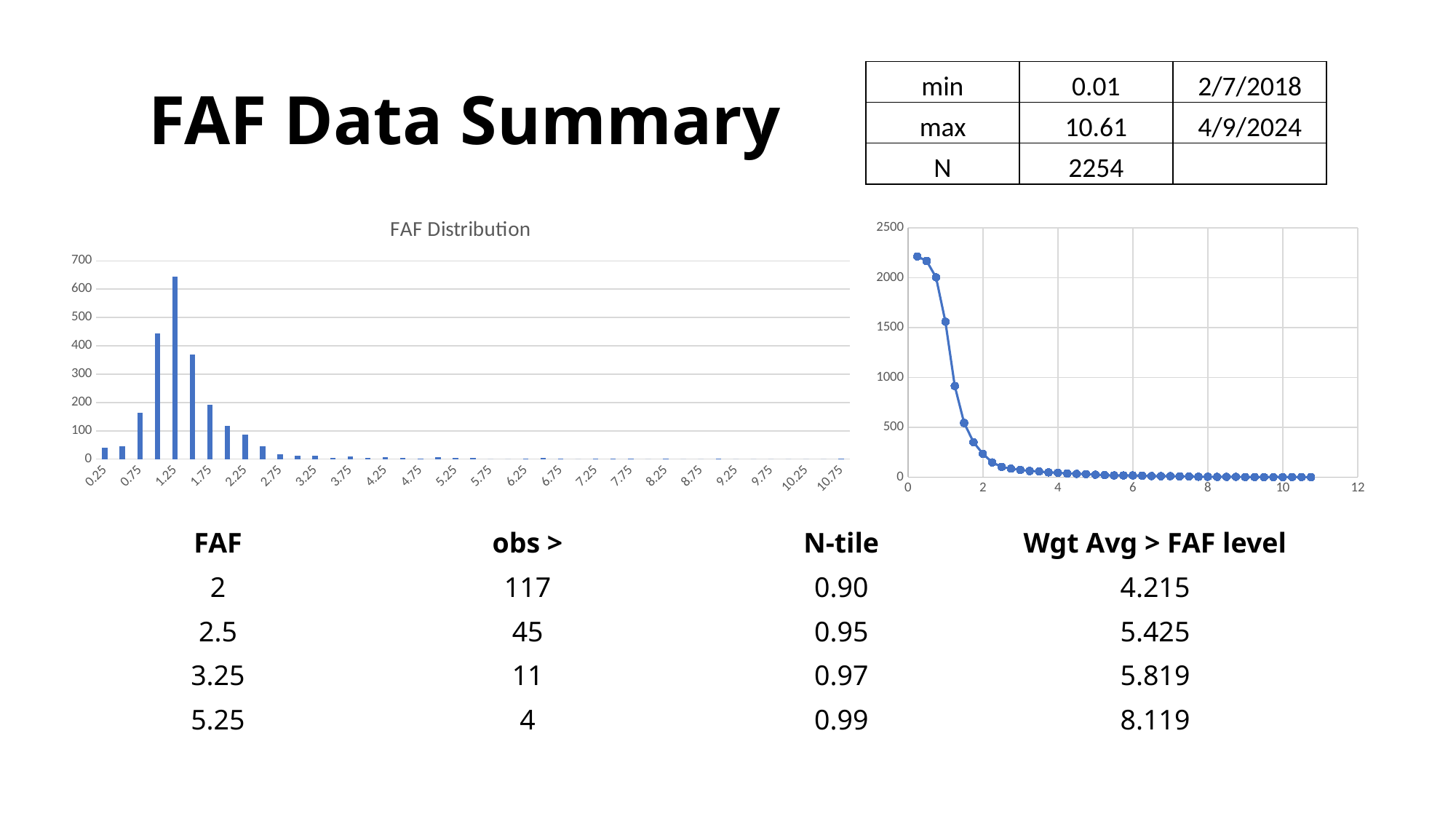
In the 'FAF Distribution' chart, is the value for 0.75 greater or less than 100? greater In the chart on the right, is the first plotted value (near x = 0) greater or less than 2000? greater What kind of chart is the 'FAF Distribution' chart on the left? bar chart In the 'FAF Distribution' chart, is the value for 1.75 greater or less than 300? less What is the title of the bar chart on the left? FAF Distribution What kind of chart is the untitled chart on the right of the slide? line chart In the chart on the right, do the values rise or fall as the x axis increases? fall In the 'FAF Distribution' chart, which bar is taller, 0.75 or 2.25? 0.75 In the 'FAF Distribution' chart, which x-axis category has the tallest bar? 1.25 How many category labels are shown on the x axis of the 'FAF Distribution' chart? 22 In the 'FAF Distribution' chart, which bar is taller, 1.25 or 1.75? 1.25